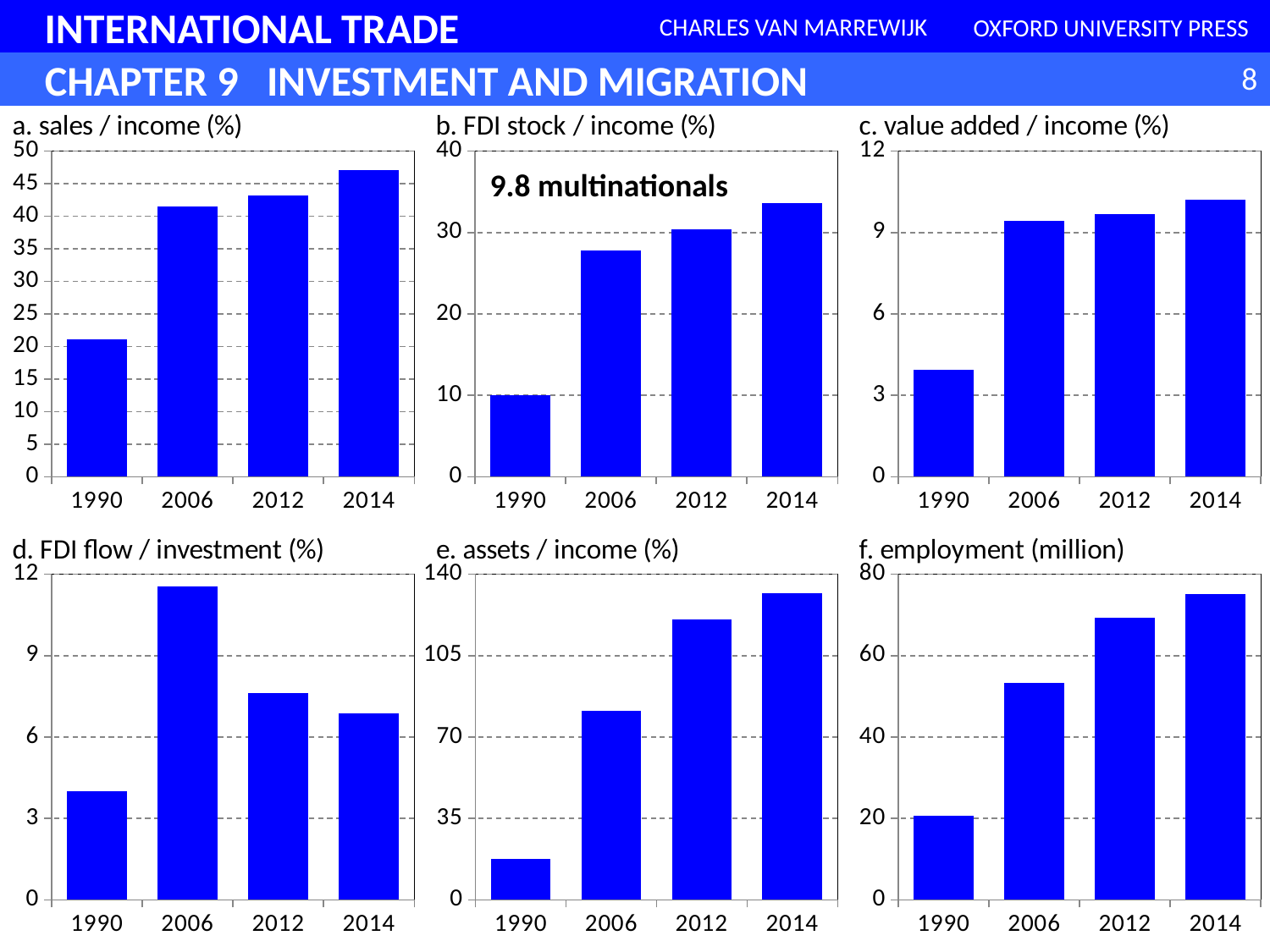
In chart e (assets / income (%)), is the value for 2006 greater or less than 70? greater What kind of chart is chart a (sales / income (%))? bar chart In chart f (employment (million)), do the values rise or fall from 1990 to 2014? rise How many years are shown on the x axis of chart e (assets / income (%))? 4 In chart d (FDI flow / investment (%)), which year has the highest value? 2006 In chart a (sales / income (%)), which year has the highest value? 2014 In chart c (value added / income (%)), is the value for 1990 greater or less than 6? less In chart b (FDI stock / income (%)), is the value for 2014 greater or less than 30? greater In chart b (FDI stock / income (%)), which year has the lowest value? 1990 In chart d (FDI flow / investment (%)), which is larger, the value for 2012 or the value for 2014? 2012